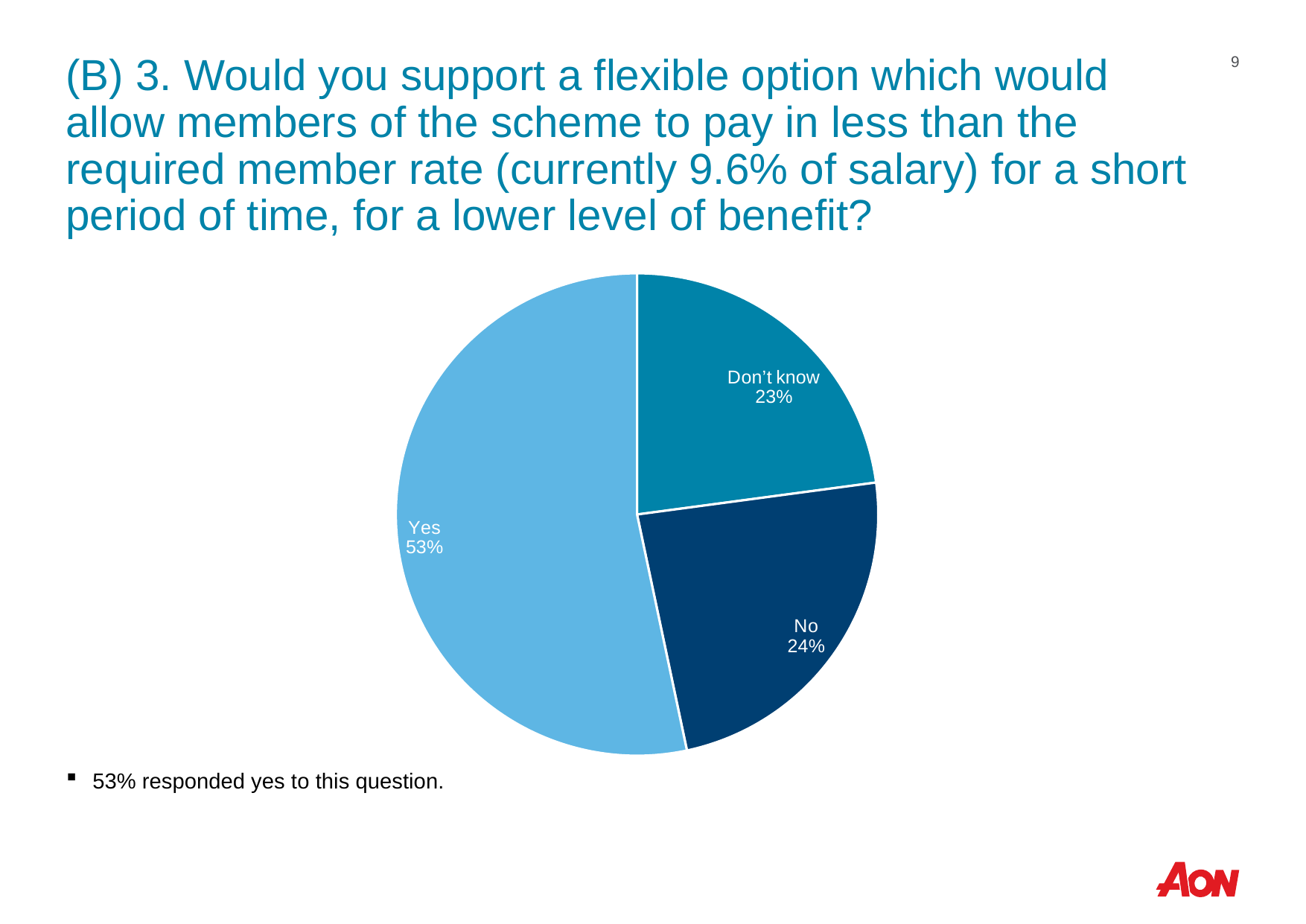
What is the combined share of the No and Don't know slices? 47% What is the difference in percentage points between the No and Don't know slices? 1 What percentage of respondents answered Yes? 53% What kind of chart is shown on the slide? Pie chart Which response has the smallest share of the pie? Don't know What percentage of respondents answered Don't know? 23% What percentage of respondents answered No? 24% Which response has the largest share of the pie? Yes Which slice of the pie is shown in the lightest blue colour? Yes What is the difference in percentage points between the Yes and No slices? 29 Which is larger, the Yes slice or the No slice? Yes How many slices does the pie chart have? 3